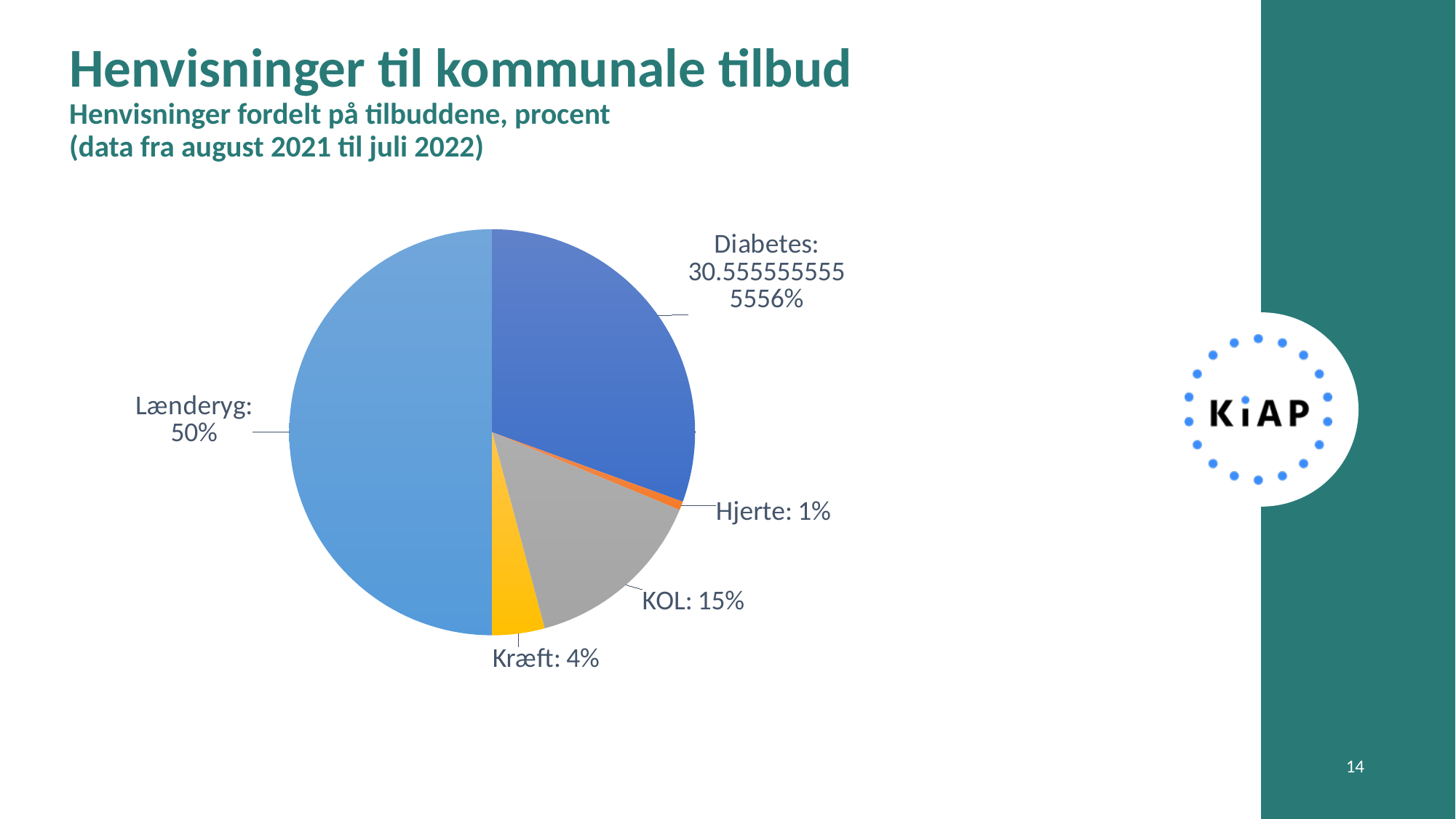
Which category has the largest slice of the pie? Lænderyg What is the value for Kræft? 4% Which is larger, KOL or Kræft? KOL What is the subtitle of the chart on the slide? Henvisninger fordelt på tilbuddene, procent (data fra august 2021 til juli 2022) What is the difference between the values for Lænderyg and KOL? 35% What kind of chart is shown on the slide? pie chart Which category has the smallest slice of the pie? Hjerte What is the value for KOL? 15% What share of the pie does Lænderyg have? 50% How many slices does the pie chart have? 5 What is the value for Hjerte? 1% What is the value shown for Diabetes? 30.5555555555556%